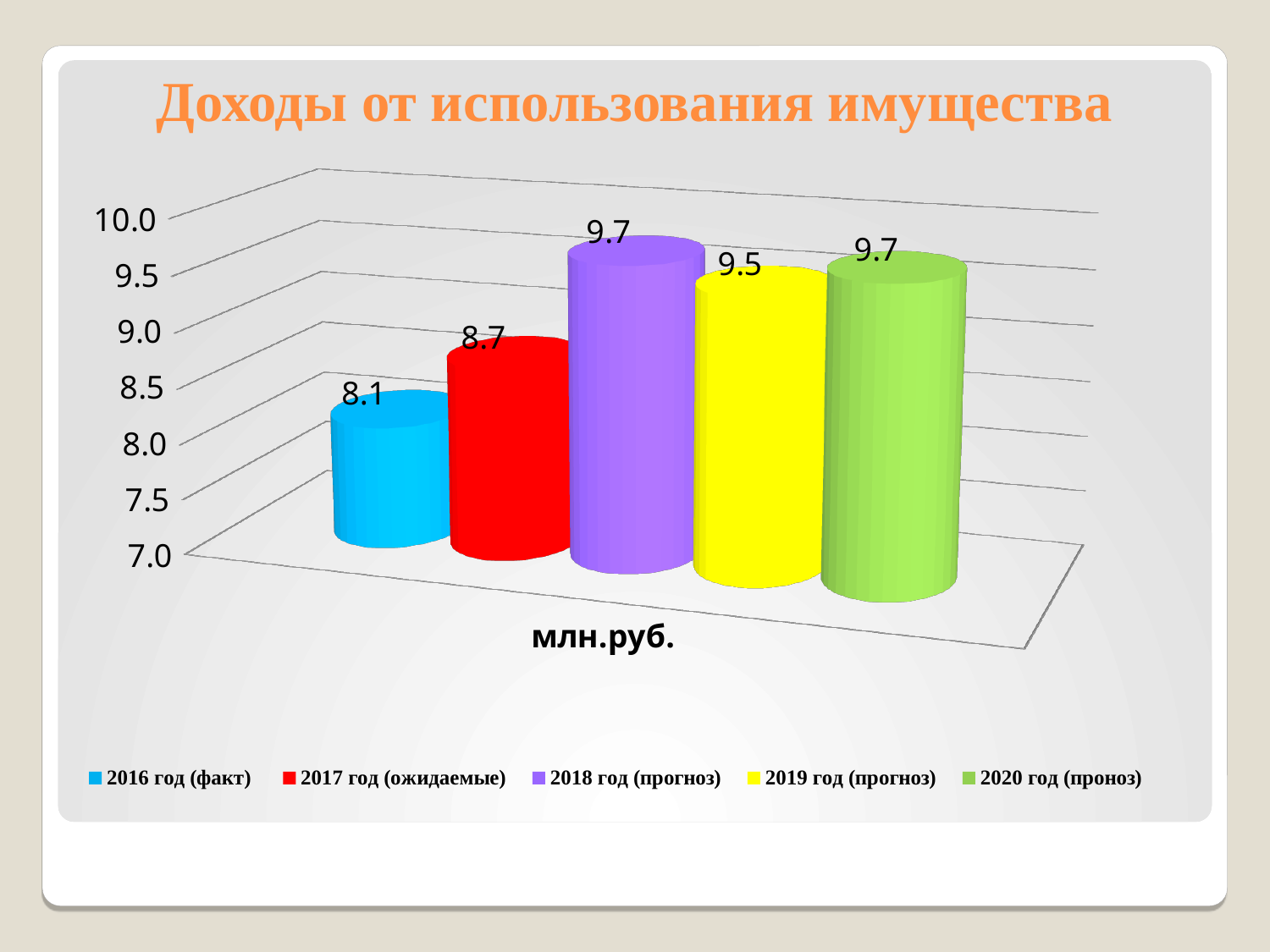
What is the difference between the values for 2017 год (ожидаемые) and 2016 год (факт)? 0.6 What is the value for 2018 год (прогноз)? 9.7 What is the difference between the values for 2018 год (прогноз) and 2016 год (факт)? 1.6 What is the value for 2016 год (факт)? 8.1 What is the value for 2017 год (ожидаемые)? 8.7 How many series does the legend list? 5 What is the value for 2019 год (прогноз)? 9.5 What is the title of the chart? Доходы от использования имущества Which is larger, the value for 2018 год (прогноз) or the value for 2019 год (прогноз)? 2018 год (прогноз) What kind of chart is shown on the slide? Bar chart What is the value for 2020 год (проноз)? 9.7 Which series has the lowest value? 2016 год (факт)